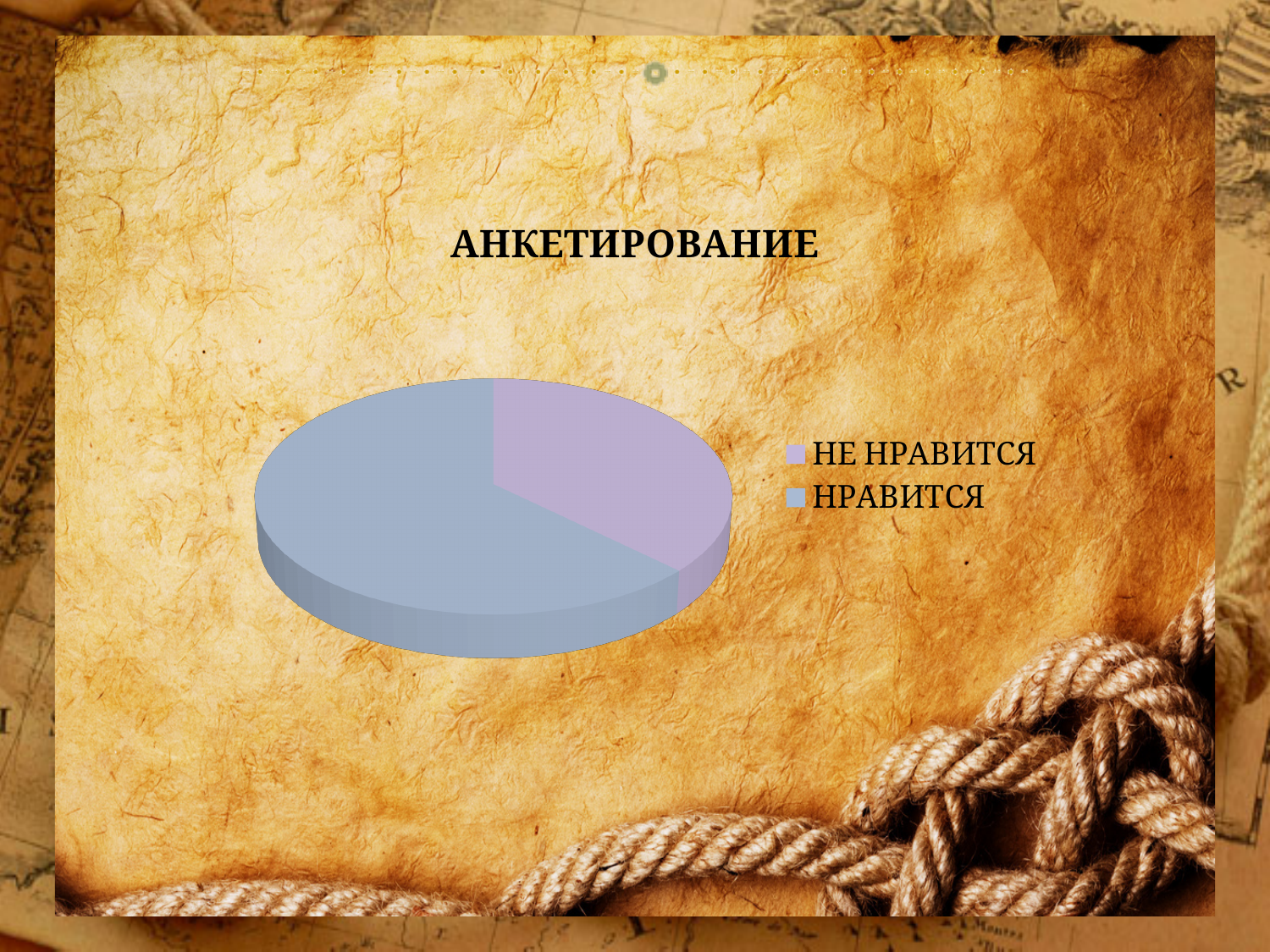
What colour is the НЕ НРАВИТСЯ slice in the pie chart? purple Which category has the smallest slice of the pie chart? НЕ НРАВИТСЯ Which slice is larger, НРАВИТСЯ or НЕ НРАВИТСЯ? НРАВИТСЯ How many entries does the legend of the pie chart list? 2 Does the НРАВИТСЯ slice take up more or less than half of the pie? more What is the title of the chart on the slide? АНКЕТИРОВАНИЕ How many slices does the pie chart have? 2 What kind of chart is shown on the slide? pie chart Which category has the largest slice of the pie chart? НРАВИТСЯ